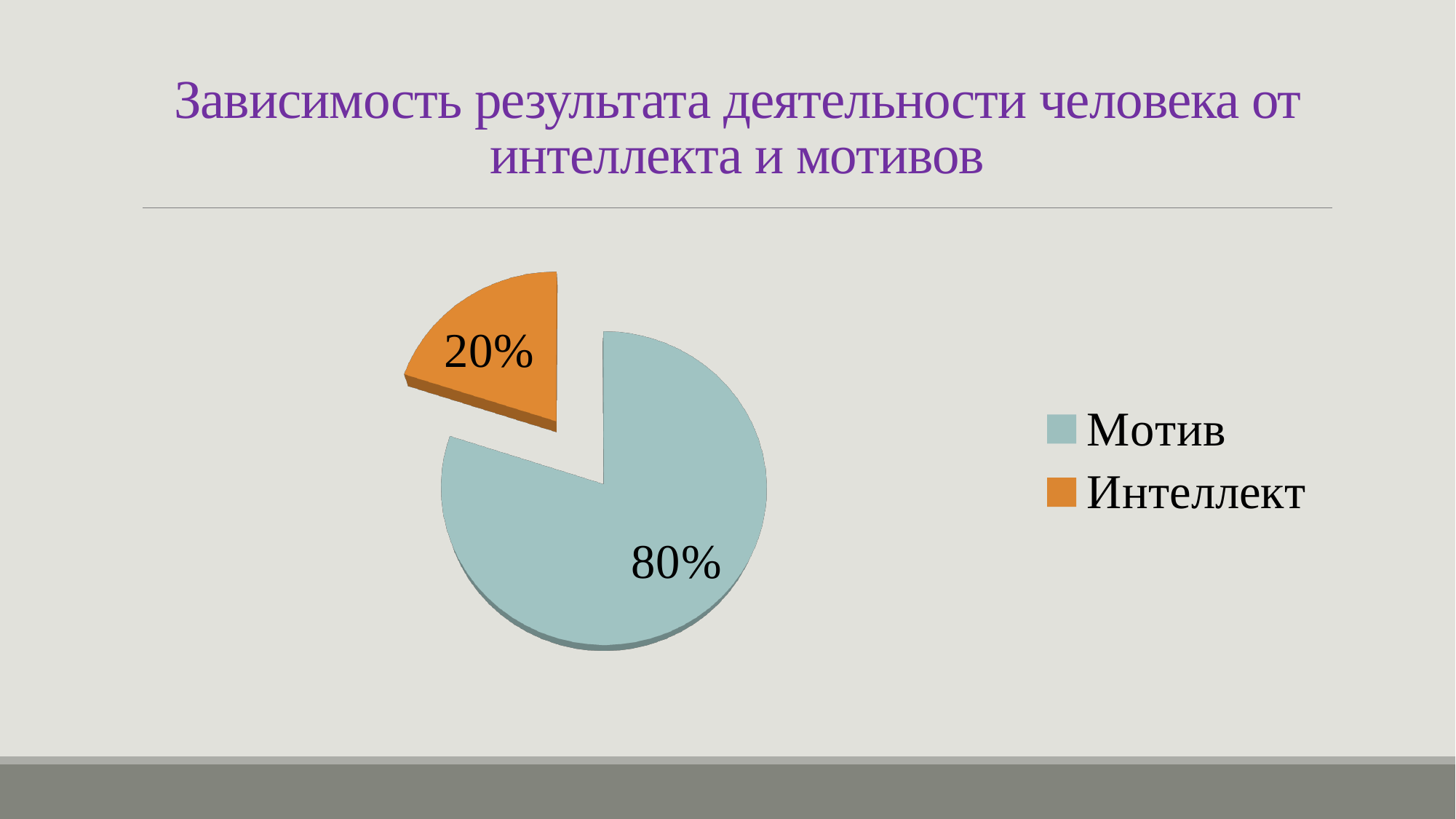
What share of the pie does Мотив take? 80% Which is larger, the Мотив slice or the Интеллект slice? Мотив What is the difference in percentage points between the Мотив and Интеллект slices? 60 What colour is the Интеллект slice? Orange What share of the pie does Интеллект take? 20% Which slice is the smallest? Интеллект What is the title of the slide? Зависимость результата деятельности человека от интеллекта и мотивов What kind of chart is shown on the slide? Pie chart How many entries does the legend list? 2 Which slice is the largest? Мотив How many slices does the pie chart have? 2